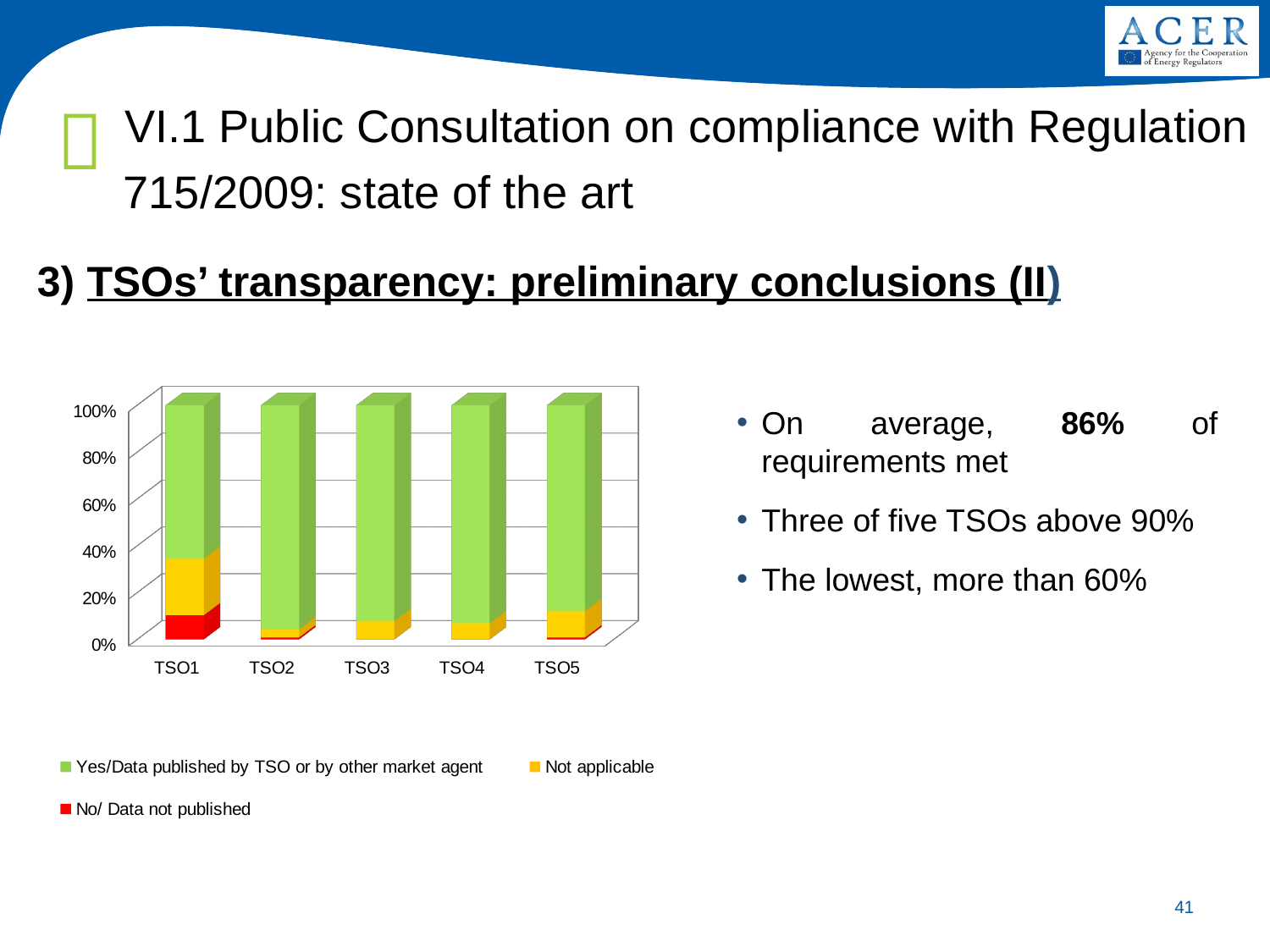
Which has a larger 'Yes/Data published by TSO or by other market agent' segment, TSO1 or TSO3? TSO3 What is the total height of the stacked bar for TSO3? 100% Which colour represents 'Not applicable' in the chart legend? Yellow Which TSO has the largest 'No/ Data not published' segment? TSO1 Which TSO has the largest 'Not applicable' segment? TSO1 What kind of chart is shown on the slide? Stacked bar chart Is the 'Yes/Data published by TSO or by other market agent' value for TSO1 greater or less than 60%? greater Is the 'Not applicable' value for TSO5 greater or less than 20%? less Is the 'Not applicable' value for TSO1 greater or less than 20%? greater How many series does the chart legend list? 3 Which TSO has the smallest 'Yes/Data published by TSO or by other market agent' segment? TSO1 How many TSOs are shown on the x axis of the chart? 5